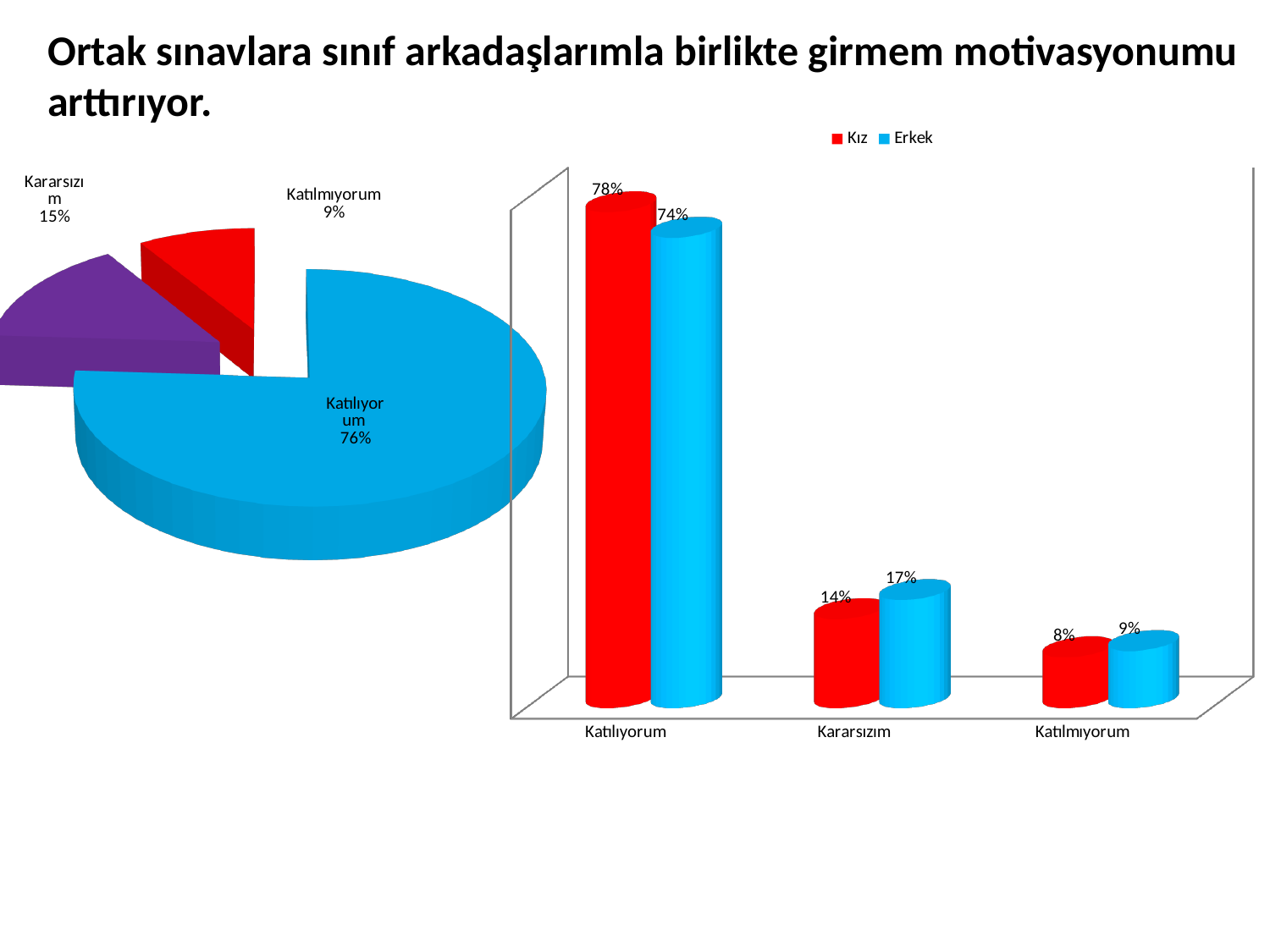
In the bar chart on the right, what is the difference between Kız and Erkek in the Katılıyorum category? 4% In the pie chart on the left, what share does Katılıyorum have? 76% In the bar chart on the right, what is the value for Erkek in the Kararsızım category? 17% In the pie chart on the left, what share does Kararsızım have? 15% In the bar chart on the right, which category has the highest value for Kız? Katılıyorum What kind of chart is on the right side of the slide? Bar chart In the bar chart on the right, how many series does the legend list? 2 In the bar chart on the right, what is the value for Erkek in the Katılmıyorum category? 9% In the bar chart on the right, what is the value for Kız in the Katılıyorum category? 78% In the pie chart on the left, which category has the smallest slice? Katılmıyorum In the bar chart on the right, which is larger in the Kararsızım category, Kız or Erkek? Erkek In the pie chart on the left, how many slices are there? 3